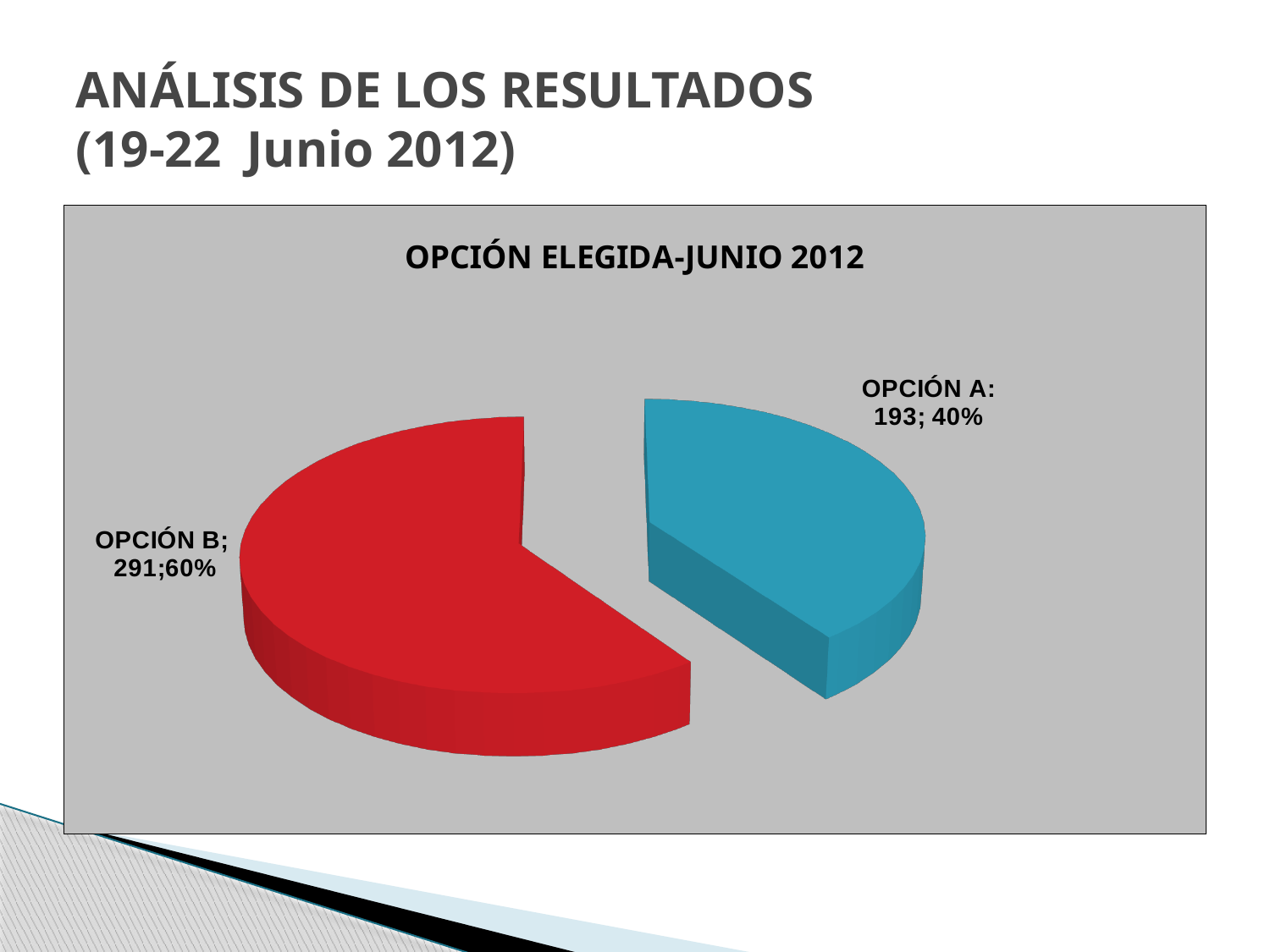
What share of the pie does OPCIÓN B represent? 60% How many slices does the pie chart have? 2 What is the title of the chart? OPCIÓN ELEGIDA-JUNIO 2012 Which option has the largest slice? OPCIÓN B What is the difference between the values for OPCIÓN B and OPCIÓN A? 98 What is the value for OPCIÓN B? 291 Which is larger, the value for OPCIÓN A or OPCIÓN B? OPCIÓN B What share of the pie does OPCIÓN A represent? 40% What is the value for OPCIÓN A? 193 What type of chart is shown on the slide? Pie chart What colour is the slice for OPCIÓN B? Red Which option has the smallest slice? OPCIÓN A